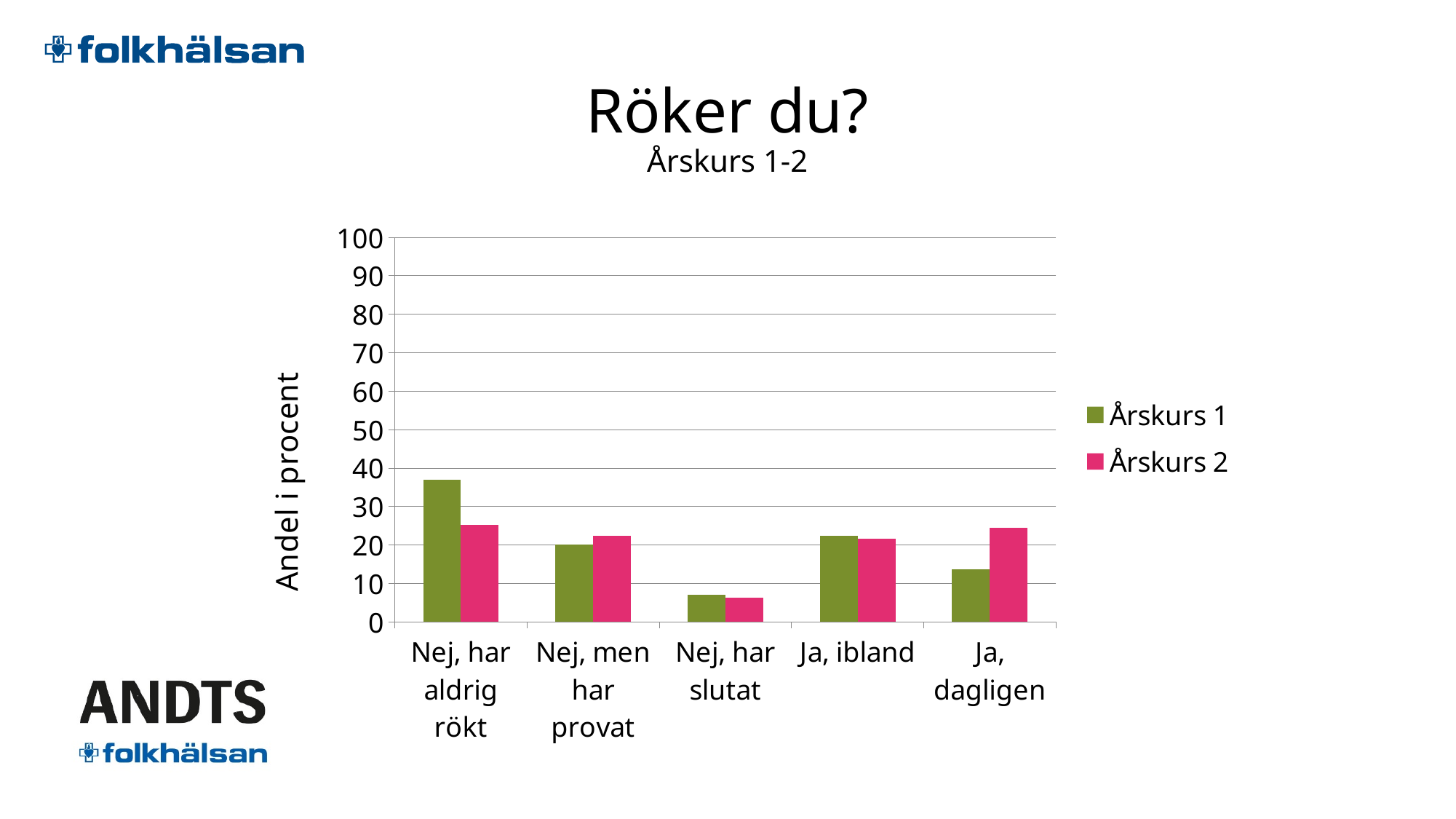
How many series does the legend list? 2 Is the value for Årskurs 1 in 'Ja, dagligen' greater or less than 20? less How many categories are shown on the x axis? 5 Which category has the lowest value for Årskurs 2? Nej, har slutat What kind of chart is shown on the slide? bar chart What is the label of the y axis? Andel i procent For 'Ja, dagligen', which series has the larger value, Årskurs 1 or Årskurs 2? Årskurs 2 Which category has the highest value for Årskurs 1? Nej, har aldrig rökt Which category has the lowest value for Årskurs 1? Nej, har slutat Is the value for Årskurs 2 in 'Nej, har slutat' greater or less than 10? less For 'Nej, har aldrig rökt', which series has the larger value, Årskurs 1 or Årskurs 2? Årskurs 1 Is the value for Årskurs 1 in 'Nej, har aldrig rökt' greater or less than 30? greater